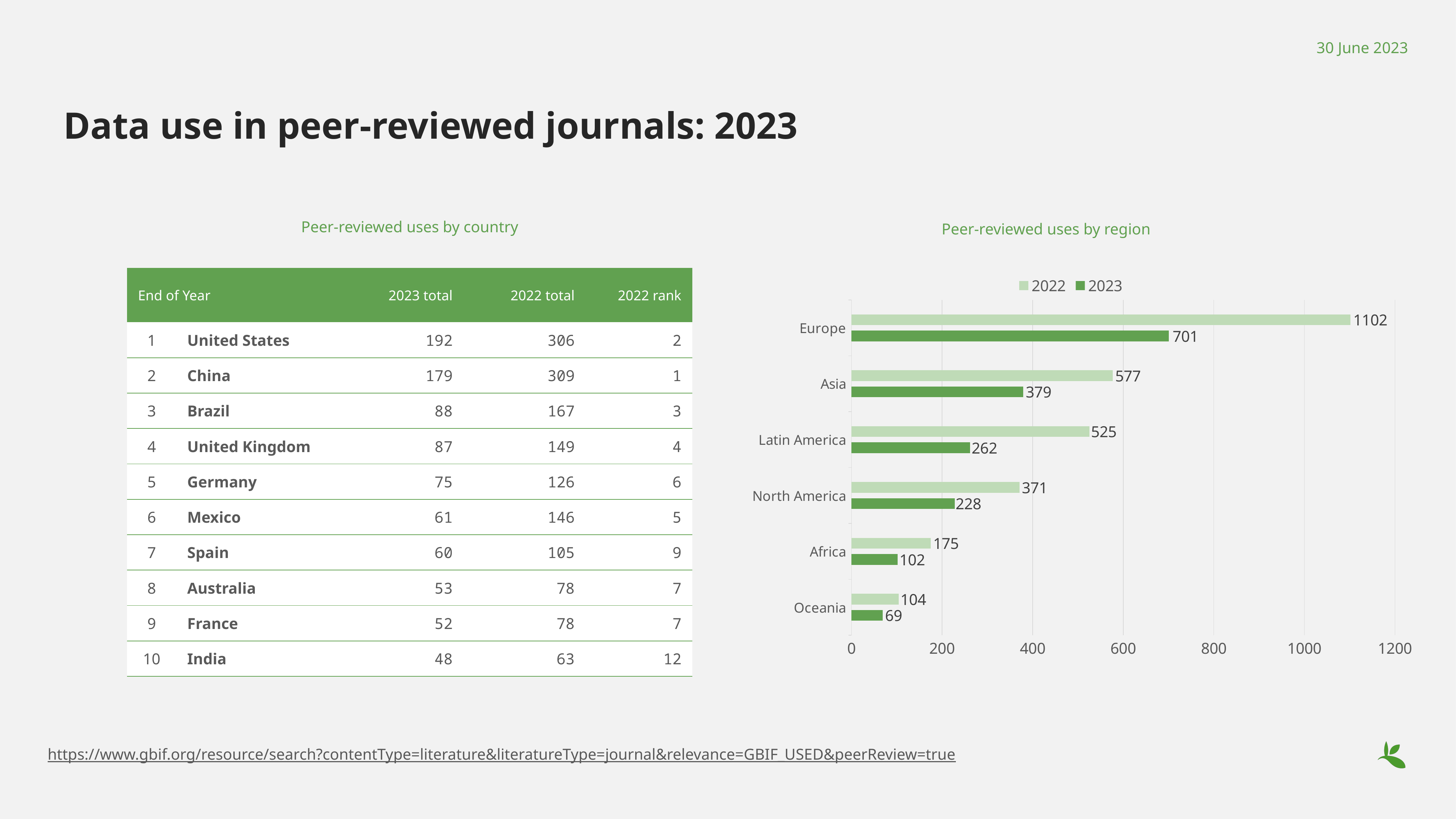
In the 'Peer-reviewed uses by region' chart, which is larger: the 2023 value for North America or the 2022 value for Africa? 2023 value for North America In the 'Peer-reviewed uses by region' chart, how many regions are shown? 6 In the 'Peer-reviewed uses by region' chart, what is the 2023 value for Europe? 701 In the 'Peer-reviewed uses by region' chart, what is the difference between the 2022 and 2023 values for Europe? 401 In the 'Peer-reviewed uses by region' chart, what is the 2023 value for Oceania? 69 In the 'Peer-reviewed uses by region' chart, which region has the highest 2022 value? Europe In the 'Peer-reviewed uses by region' chart, what is the 2022 value for Asia? 577 In the 'Peer-reviewed uses by region' chart, how many series does the legend list? 2 In the 'Peer-reviewed uses by region' chart, what is the maximum value shown on the horizontal axis? 1200 In the 'Peer-reviewed uses by region' chart, what is the difference between the 2023 values for Asia and Latin America? 117 What type of chart is 'Peer-reviewed uses by region'? Bar chart In the 'Peer-reviewed uses by region' chart, which region has the lowest 2023 value? Oceania